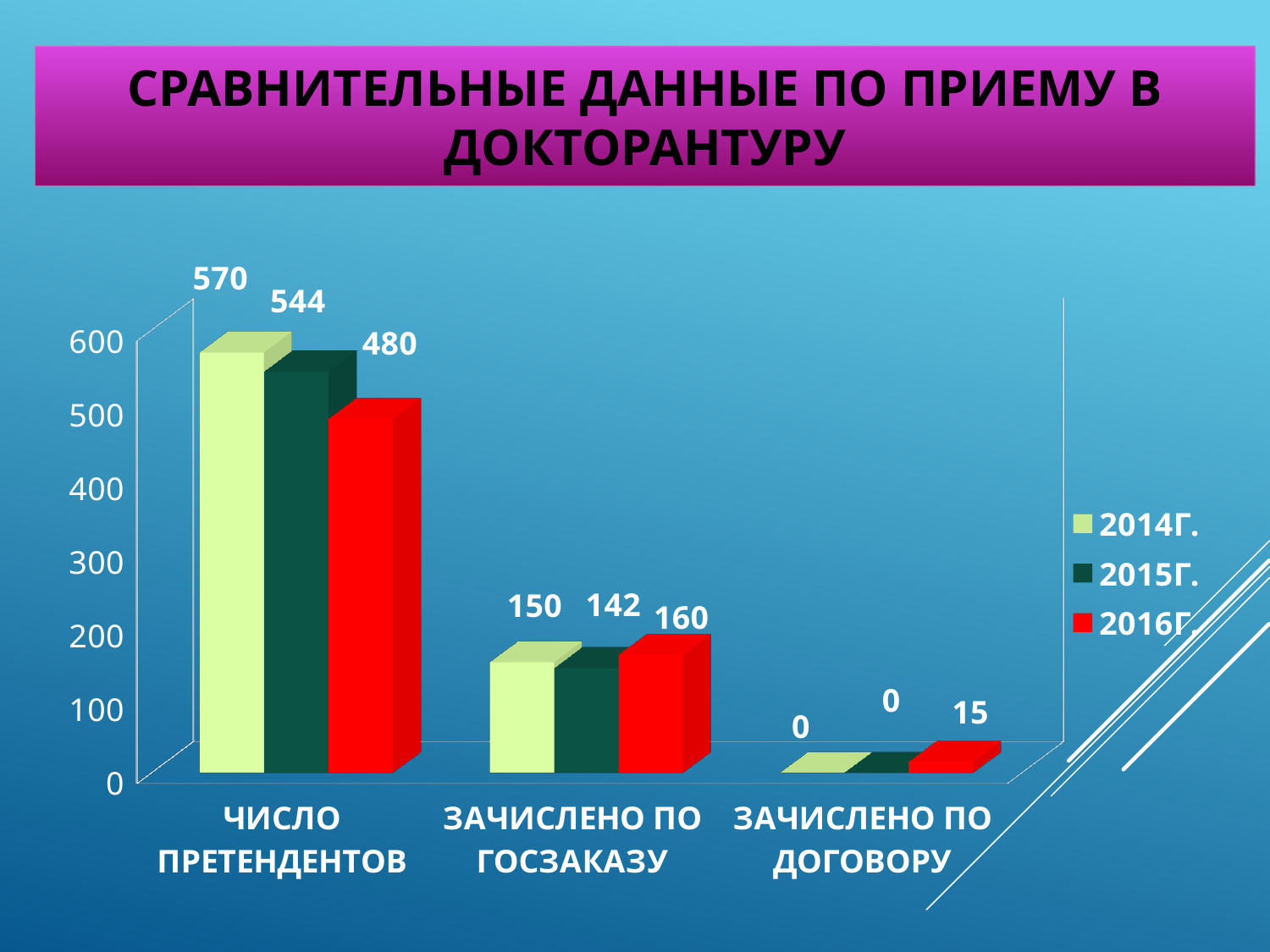
What is the difference between the 2014г. and 2016г. values for 'Число претендентов'? 90 How many series does the legend list? 3 Which is larger: the 2015г. value for 'Число претендентов' or the 2016г. value for 'Число претендентов'? 2015г. What is the value for 2016г. in the 'Зачислено по договору' category? 15 Which year has the highest value in the 'Число претендентов' category? 2014г. Which year has the lowest value in the 'Зачислено по госзаказу' category? 2015г. What kind of chart is shown on the slide? bar chart What is the value for 2016г. in the 'Зачислено по госзаказу' category? 160 What is the value for 2014г. in the 'Число претендентов' category? 570 What is the title of the slide? Сравнительные данные по приему в докторантуру What is the difference between the 2016г. and 2015г. values for 'Зачислено по госзаказу'? 18 How many categories are shown on the x axis? 3